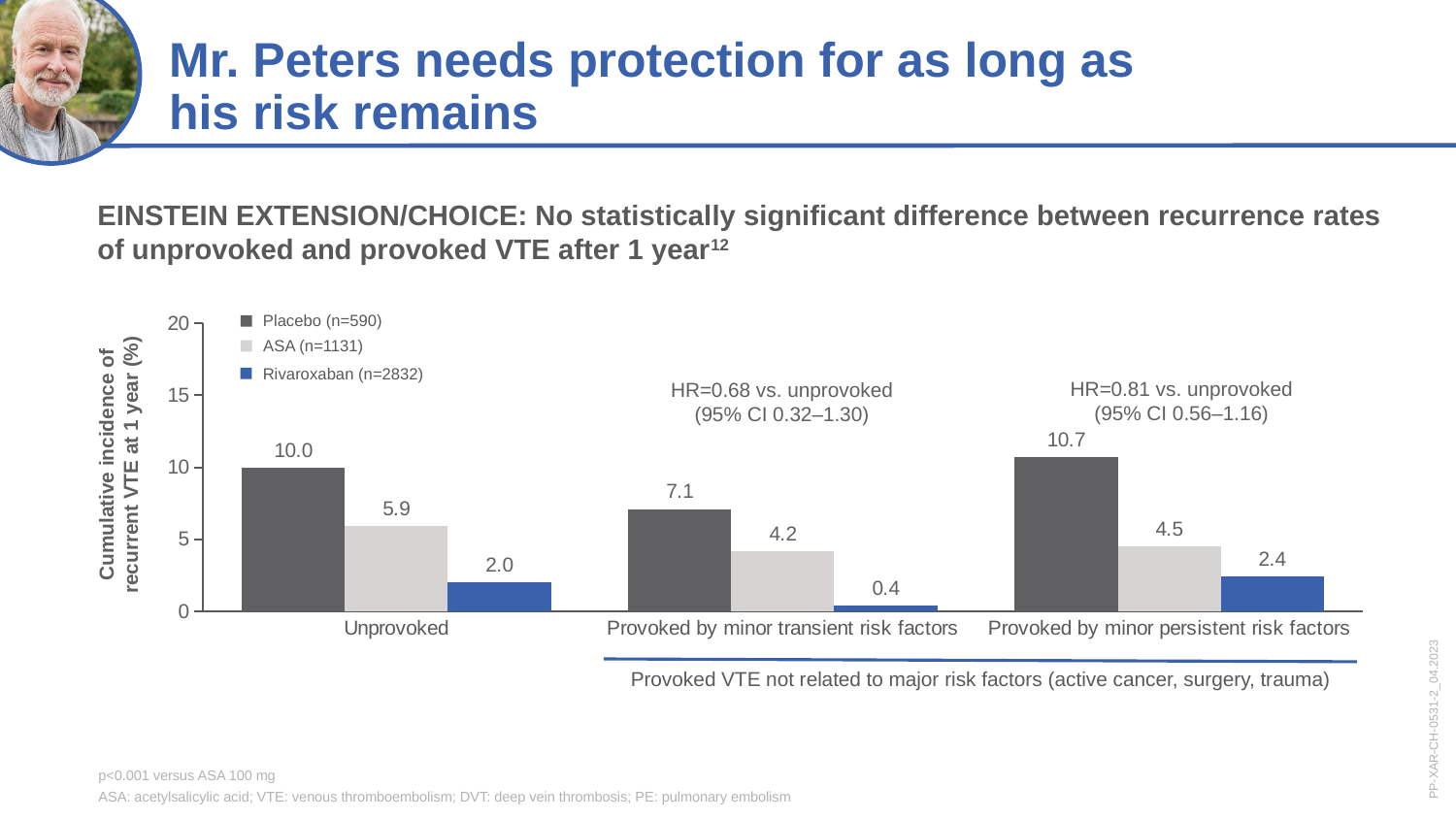
Which category has the lowest Rivaroxaban value? Provoked by minor transient risk factors Which category has the highest Placebo value? Provoked by minor persistent risk factors What is the value for ASA in the group provoked by minor persistent risk factors? 4.5 What is the sample size for the Rivaroxaban group in the legend? n=2832 Which is larger: the ASA value for Unprovoked or the ASA value for Provoked by minor persistent risk factors? Unprovoked What is the value for Rivaroxaban in the group provoked by minor transient risk factors? 0.4 What is the difference between the Placebo and Rivaroxaban values in the Unprovoked group? 8.0 How many categories are shown on the x axis? 3 How many series does the legend list? 3 What is the cumulative incidence of recurrent VTE at 1 year for Placebo in the Unprovoked group? 10.0 What kind of chart is shown on the slide? Bar chart What is the hazard ratio shown for the group provoked by minor transient risk factors vs. unprovoked? HR=0.68